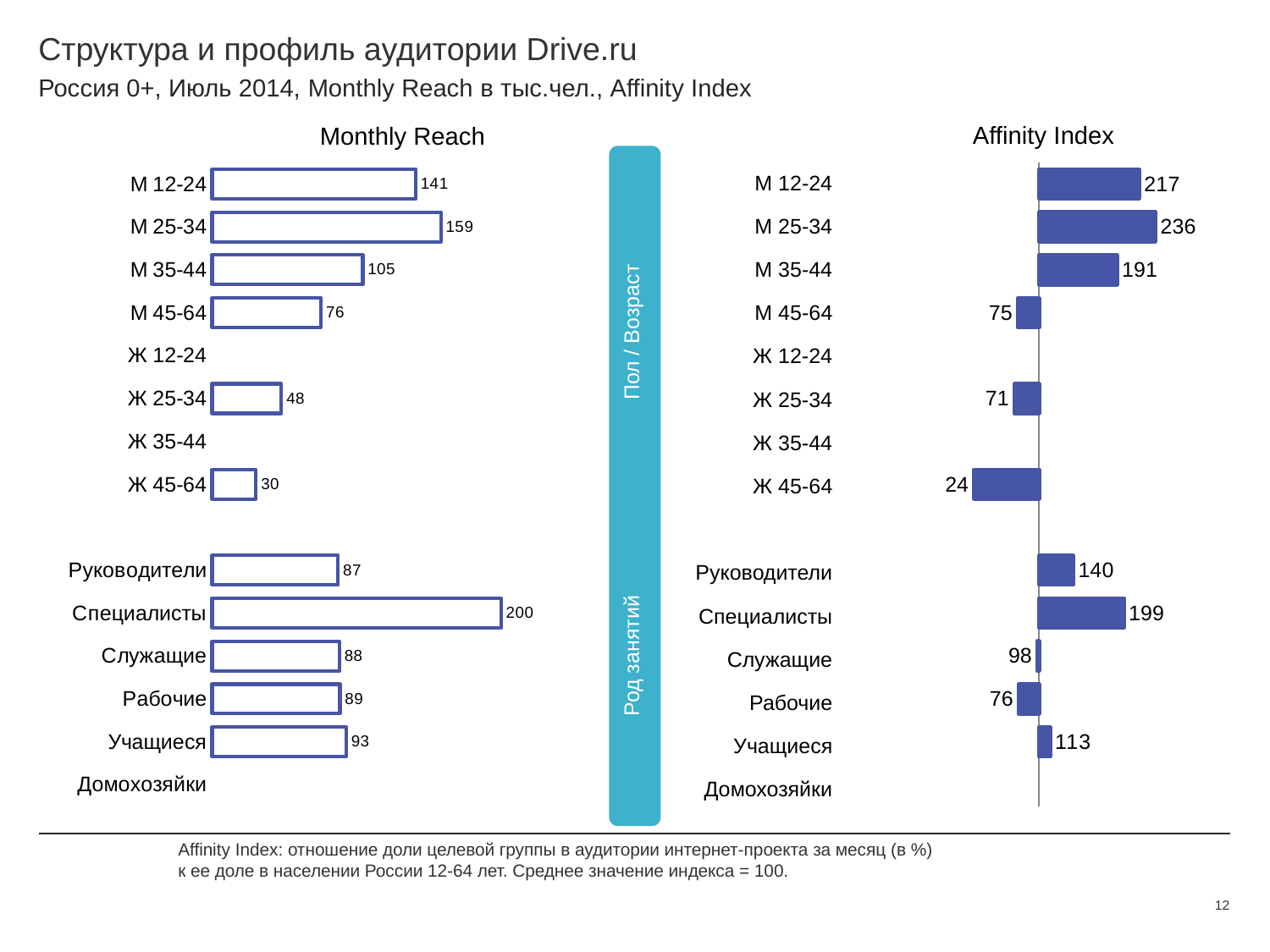
In the Monthly Reach chart, which labelled category has the lowest value? Ж 45-64 In the Affinity Index chart, what is the difference between the values for Специалисты and Учащиеся? 86 In the Monthly Reach chart, what is the value for Специалисты? 200 What is the title of the chart on the right side of the slide? Affinity Index In the Affinity Index chart, what is the value for Руководители? 140 In the Affinity Index chart, what is the value for Ж 45-64? 24 In the Monthly Reach chart, what is the difference between the values for М 12-24 and М 35-44? 36 In the Affinity Index chart, which category has the highest value? М 25-34 What kind of chart is the Monthly Reach chart? Bar chart In the Affinity Index chart, which is larger, the value for М 45-64 or the value for Ж 25-34? М 45-64 In the Monthly Reach chart, what is the value for М 25-34? 159 In the Monthly Reach chart, which is larger, the value for Рабочие or the value for Руководители? Рабочие